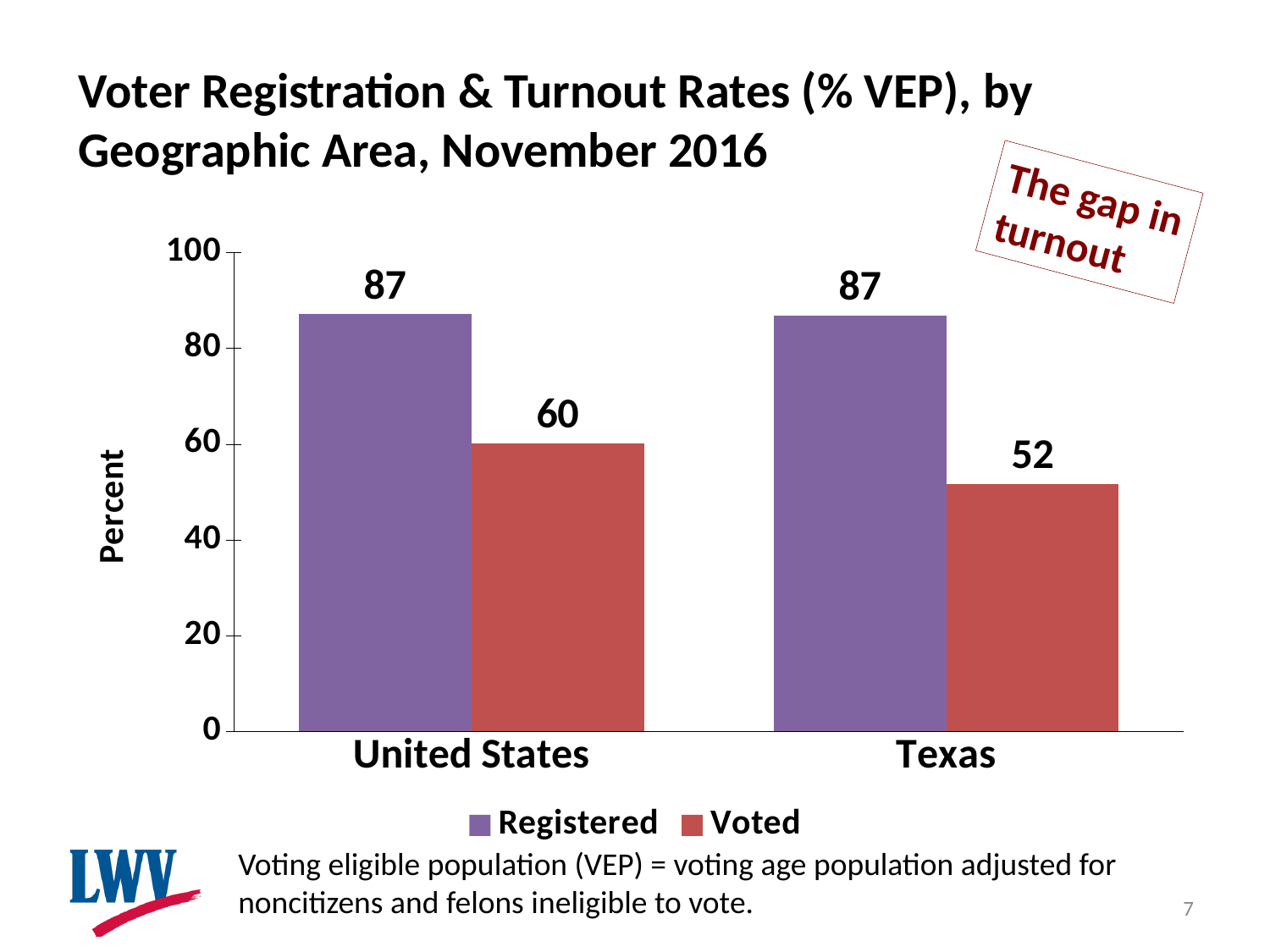
What is the Registered value for Texas? 87 What is the Registered value for the United States? 87 How many geographic areas are shown on the x axis? 2 What is the Voted value for Texas? 52 Which geographic area has the lowest Voted value? Texas What is the difference between the Voted values for the United States and Texas? 8 What kind of chart is shown on the slide? bar chart How many series does the legend list? 2 Which is larger, the Voted value for the United States or the Voted value for Texas? United States What is the Voted value for the United States? 60 What is the difference between the Registered and Voted values for Texas? 35 Is the Voted value for Texas greater or less than 60? less